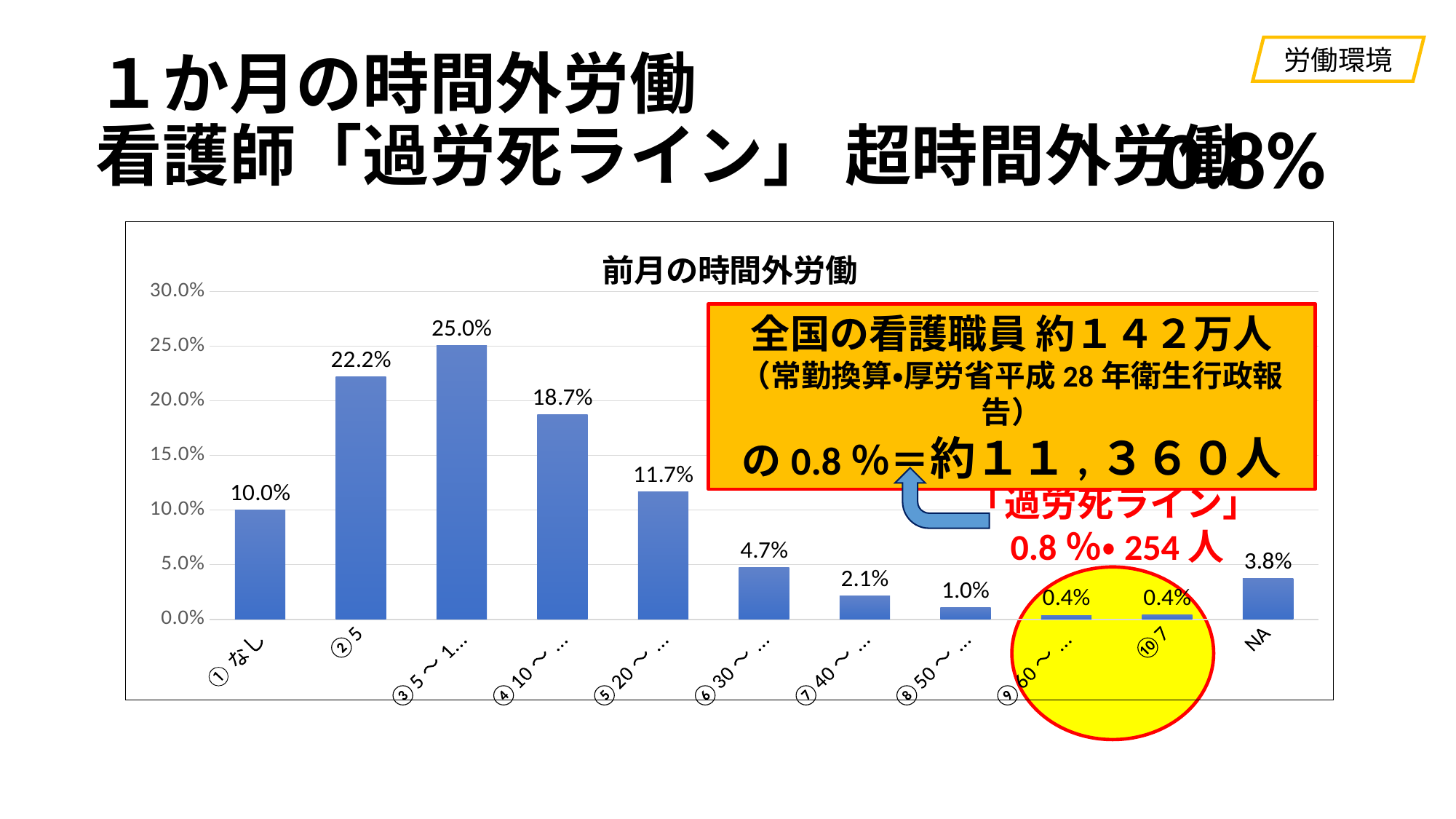
Do the values rise or fall from the third bar (③) to the eighth bar (⑧)? fall How many bars are plotted in the chart? 11 What is the value of the third bar from the left (③)? 25.0% What kind of chart is shown on the slide? bar chart What is the value for the category ①なし? 10.0% Which is larger, the value for ①なし or the value for NA? ①なし What is the difference between the values for ①なし and NA? 6.2% What is the value of the second bar from the left (②5)? 22.2% What is the title of the chart? 前月の時間外労働 Which category has the highest value? ③ (the third bar, 25.0%) What is the value of the ninth bar from the left (⑨)? 0.4% What is the value for the category NA? 3.8%